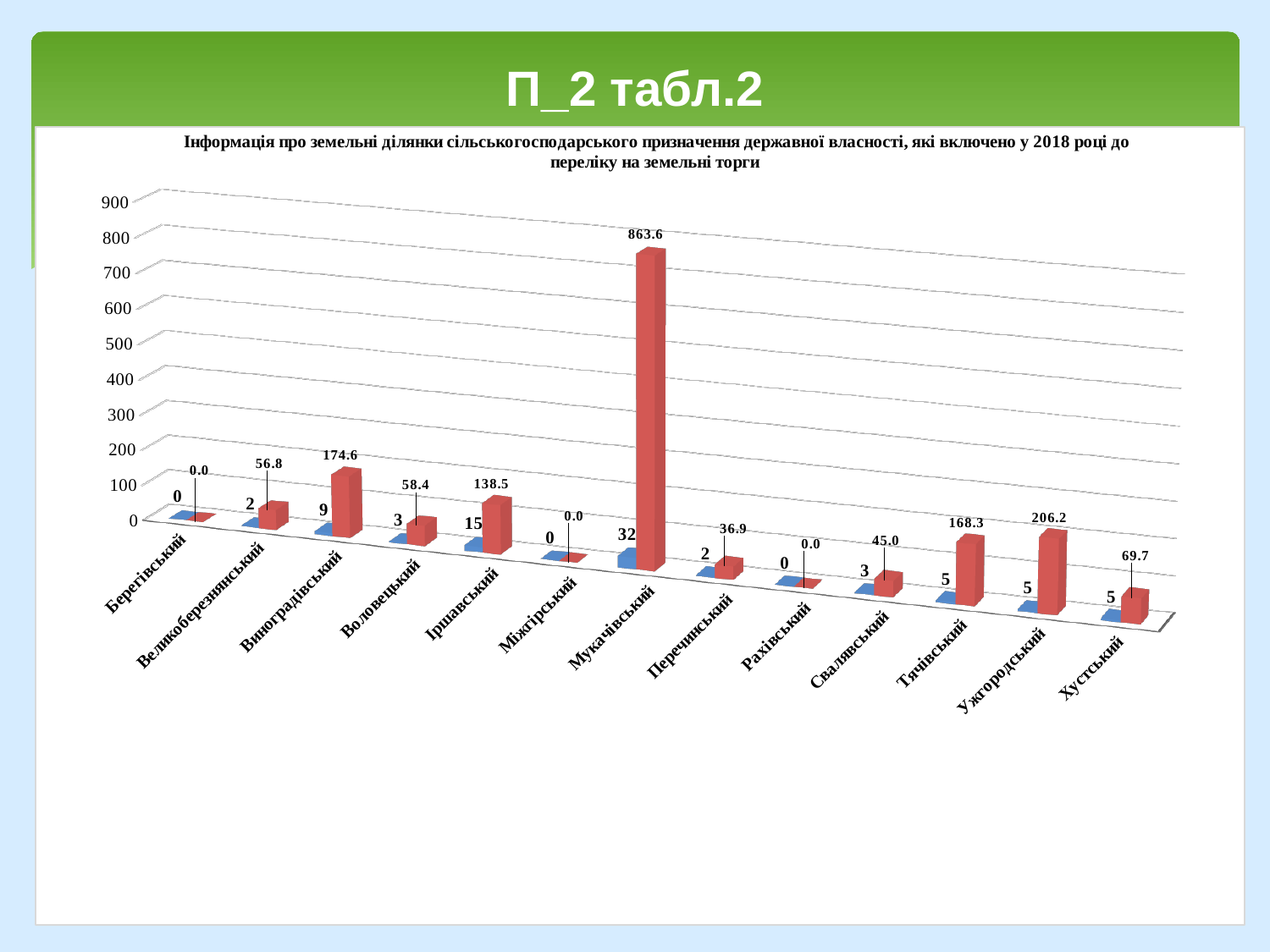
What kind of chart is shown on the slide? bar chart How many categories have a red bar value of 0.0? 3 What is the value of the red bar for Ужгородський? 206.2 Which category has the highest red bar? Мукачівський How many categories are shown on the x axis? 13 Is the red bar value for Мукачівський greater or less than 800? greater Which has a larger red bar value, Виноградівський or Іршавський? Виноградівський Which category has the highest blue bar? Мукачівський What is the difference between the red bar values for Ужгородський and Тячівський? 37.9 What is the value of the blue bar for Іршавський? 15 What is the value of the red bar for Мукачівський? 863.6 What is the value of the blue bar for Виноградівський? 9